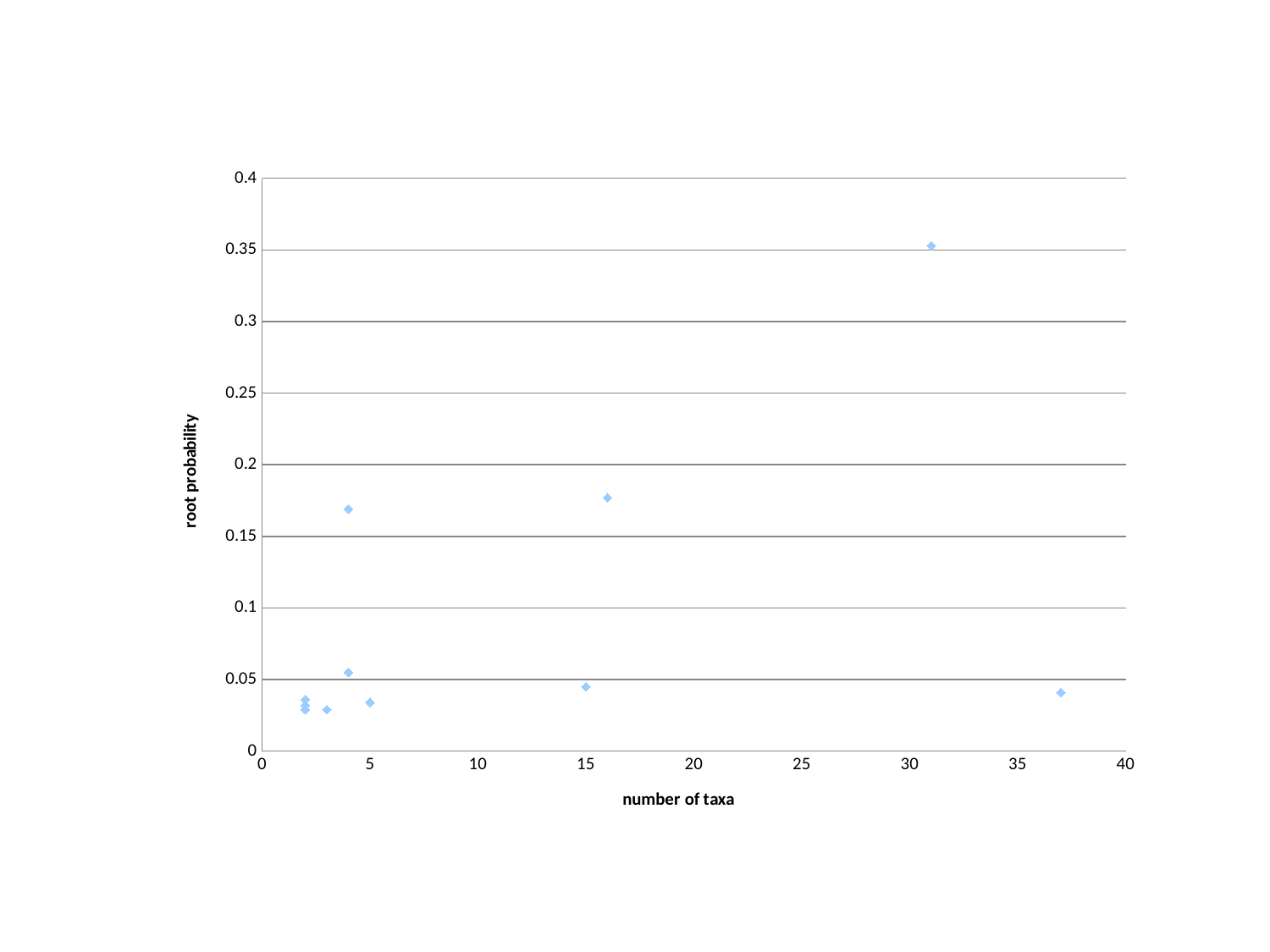
Is the root probability of the point plotted near 15 taxa greater or less than 0.1? less Is the root probability of the point plotted near 31 taxa greater or less than 0.3? greater Are all the points with fewer than 10 taxa below a root probability of 0.2? yes Which has the higher root probability: the point near 15 taxa or the point near 16 taxa? the point near 16 taxa Does the point with the highest root probability have more or fewer than 30 taxa? more Which has the higher root probability: the point near 31 taxa or the point near 37 taxa? the point near 31 taxa Is the highest root probability on the chart greater or less than 0.3? greater What is the title of the y axis? root probability What is the title of the x axis? number of taxa What kind of chart is shown on the slide? scatter plot